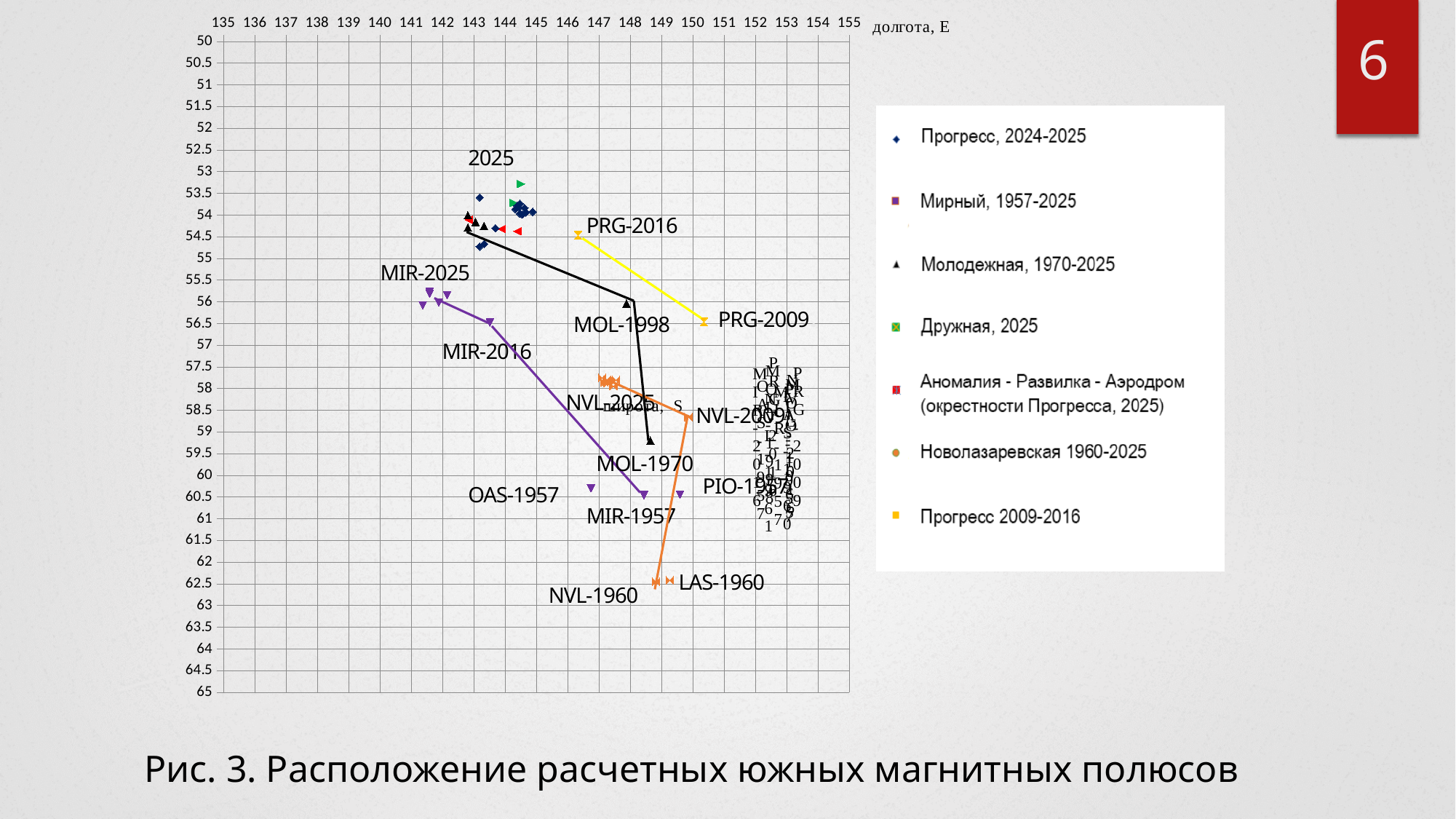
Is the longitude of the point PRG-2009 greater or less than 149? greater Is the latitude value of the point NVL-1960 greater or less than 62? greater Which point has the larger latitude value, NVL-1960 or MOL-1998? NVL-1960 How many series does the legend list? 7 Is the latitude value of the point MIR-1957 greater or less than 60? greater Which legend entry is drawn in yellow? Прогресс 2009-2016 What is the label of the horizontal axis? долгота, E Which point has the larger longitude, PRG-2009 or MIR-2016? PRG-2009 What kind of chart is shown on the slide? scatter chart